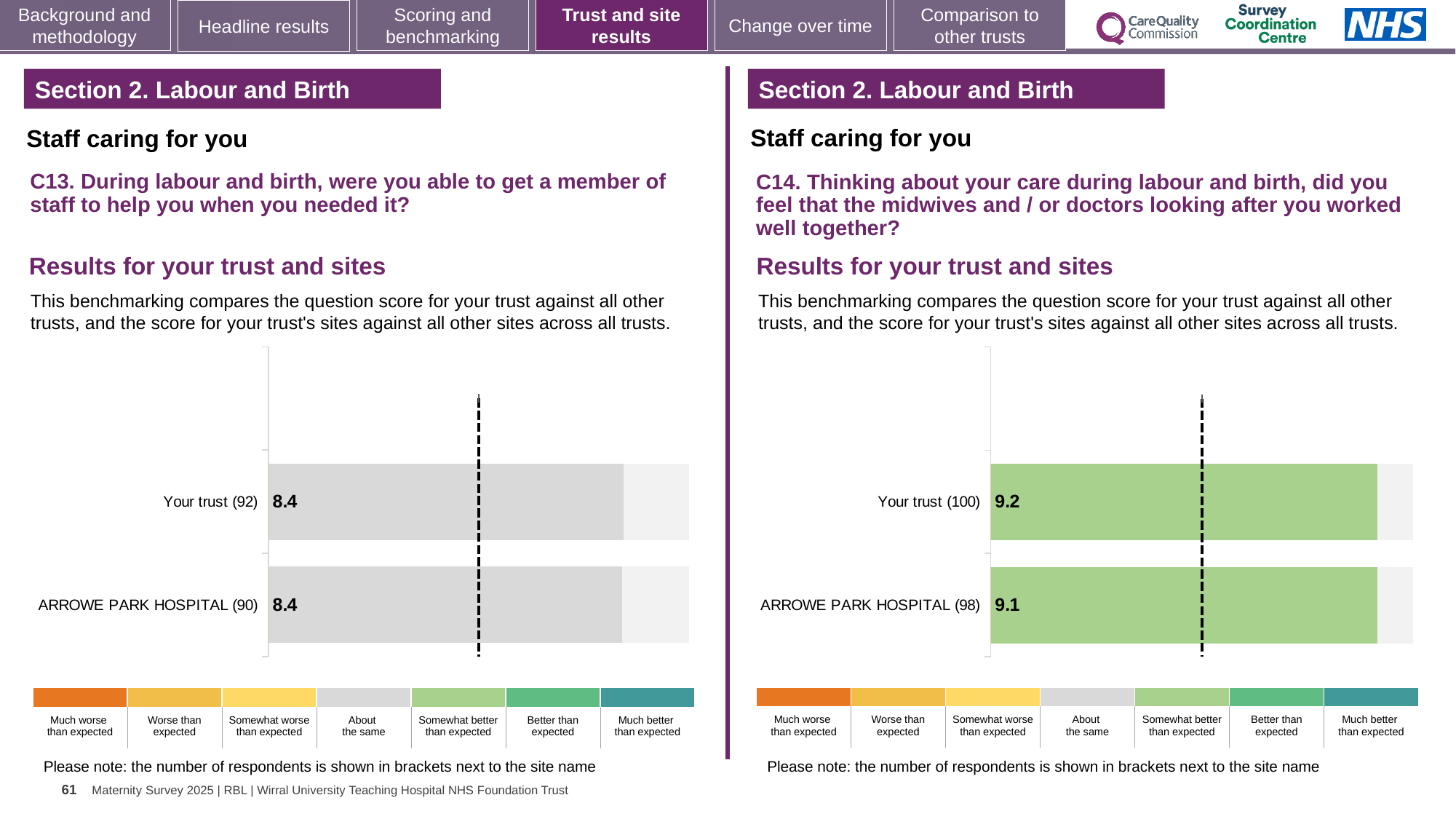
What type of chart is used for the C13 results on the left? Bar chart In the C14 chart on the right, what is the score for ARROWE PARK HOSPITAL? 9.1 In the C13 chart on the left, what is the score for Your trust? 8.4 In the C13 chart on the left, what is the score for ARROWE PARK HOSPITAL? 8.4 In the C13 chart on the left, how many respondents are shown in brackets for Your trust? 92 In the C14 chart on the right, what is the difference between the Your trust score and the ARROWE PARK HOSPITAL score? 0.1 How many bars are plotted in the C13 chart on the left? 2 In the C14 chart on the right, what is the score for Your trust? 9.2 In the C14 chart on the right, which has the higher score, Your trust or ARROWE PARK HOSPITAL? Your trust In the C14 chart on the right, how many respondents are shown in brackets for ARROWE PARK HOSPITAL? 98 In the C13 chart on the left, what is the difference between the Your trust score and the ARROWE PARK HOSPITAL score? 0 How many bars are plotted in the C14 chart on the right? 2